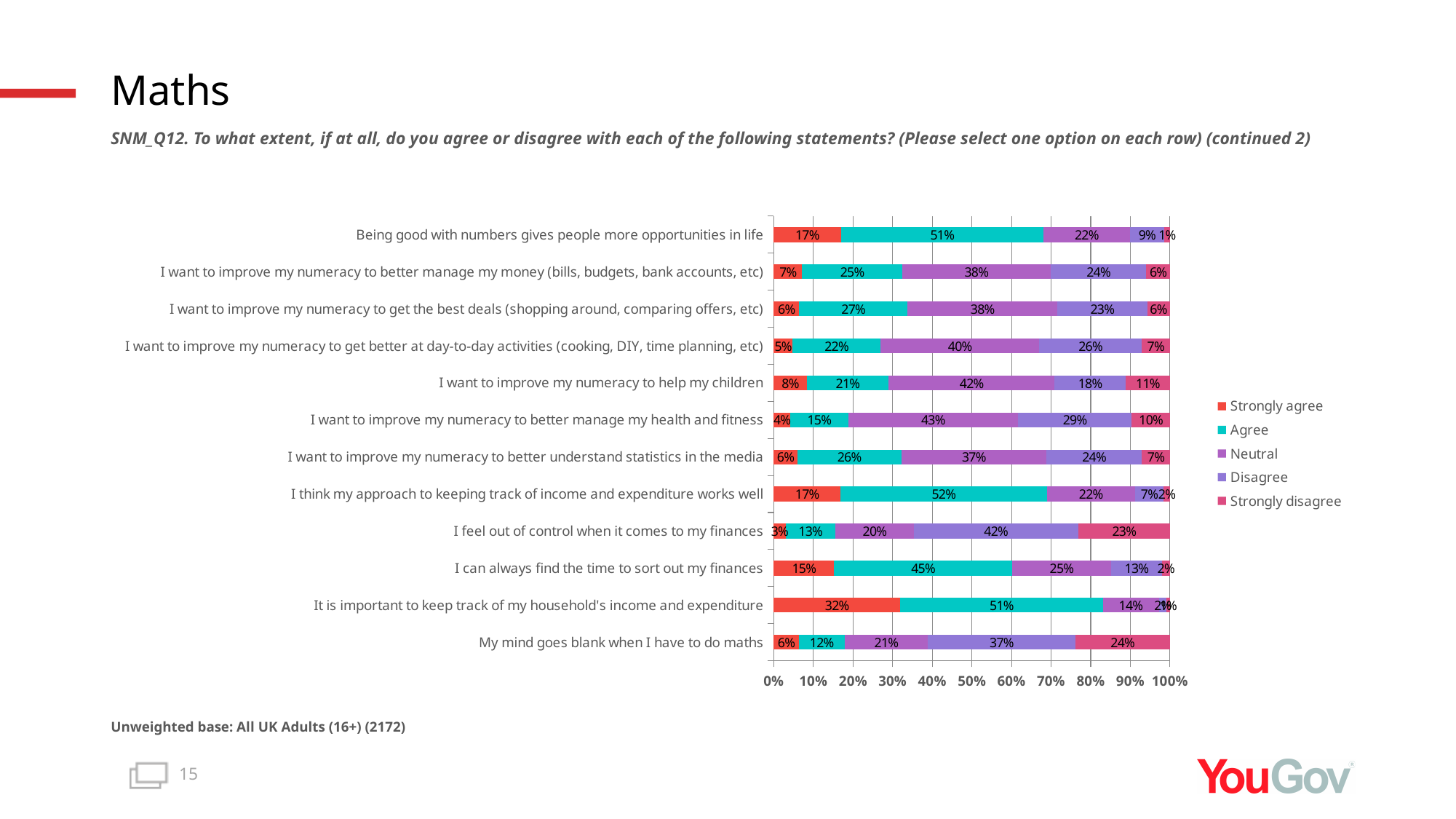
What kind of chart is shown on the slide? Stacked bar chart What is the difference between the 'Disagree' percentage for 'I feel out of control when it comes to my finances' and for 'I want to improve my numeracy to help my children'? 24% What percentage of respondents are neutral on 'I want to improve my numeracy to help my children'? 42% Which legend entry is shown in teal? Agree Which statement has the lowest 'Agree' percentage? My mind goes blank when I have to do maths How many series does the legend list? 5 Which statement has the highest 'Strongly agree' percentage? It is important to keep track of my household's income and expenditure What percentage of respondents agree with 'I can always find the time to sort out my finances'? 45% How many statements are shown in the chart? 12 What percentage of respondents strongly agree that being good with numbers gives people more opportunities in life? 17% Which has a larger 'Neutral' share: 'I want to improve my numeracy to better manage my health and fitness' or 'I want to improve my numeracy to better understand statistics in the media'? I want to improve my numeracy to better manage my health and fitness What percentage of respondents strongly disagree with 'My mind goes blank when I have to do maths'? 24%